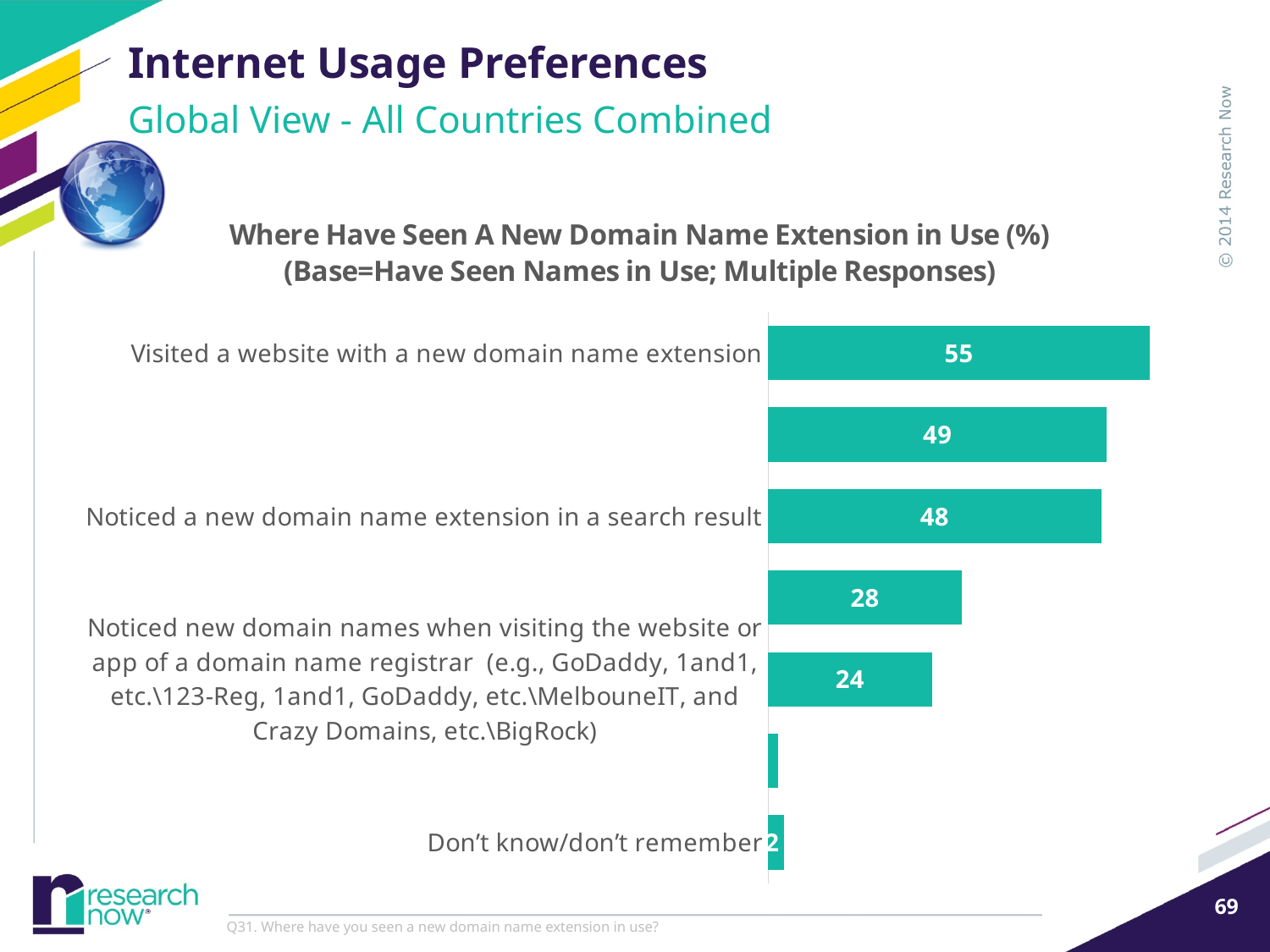
What is the title of the chart? Where Have Seen A New Domain Name Extension in Use (%) (Base=Have Seen Names in Use; Multiple Responses) What is the difference between the value for "Visited a website with a new domain name extension" and the value for "Noticed a new domain name extension in a search result"? 7 What is the second-highest value printed on the chart? 49 What colour are the bars in the chart? Teal What is the value for "Visited a website with a new domain name extension"? 55 Which category has the highest value in the chart? Visited a website with a new domain name extension What is the value for "Noticed a new domain name extension in a search result"? 48 What is the value for "Don't know/don't remember"? 2 How many bars are plotted in the chart? 7 Which is larger: the value for "Visited a website with a new domain name extension" or the value for "Noticed a new domain name extension in a search result"? Visited a website with a new domain name extension What kind of chart is shown on the slide? Bar chart What is the difference between the value for "Visited a website with a new domain name extension" and the value for "Don't know/don't remember"? 53